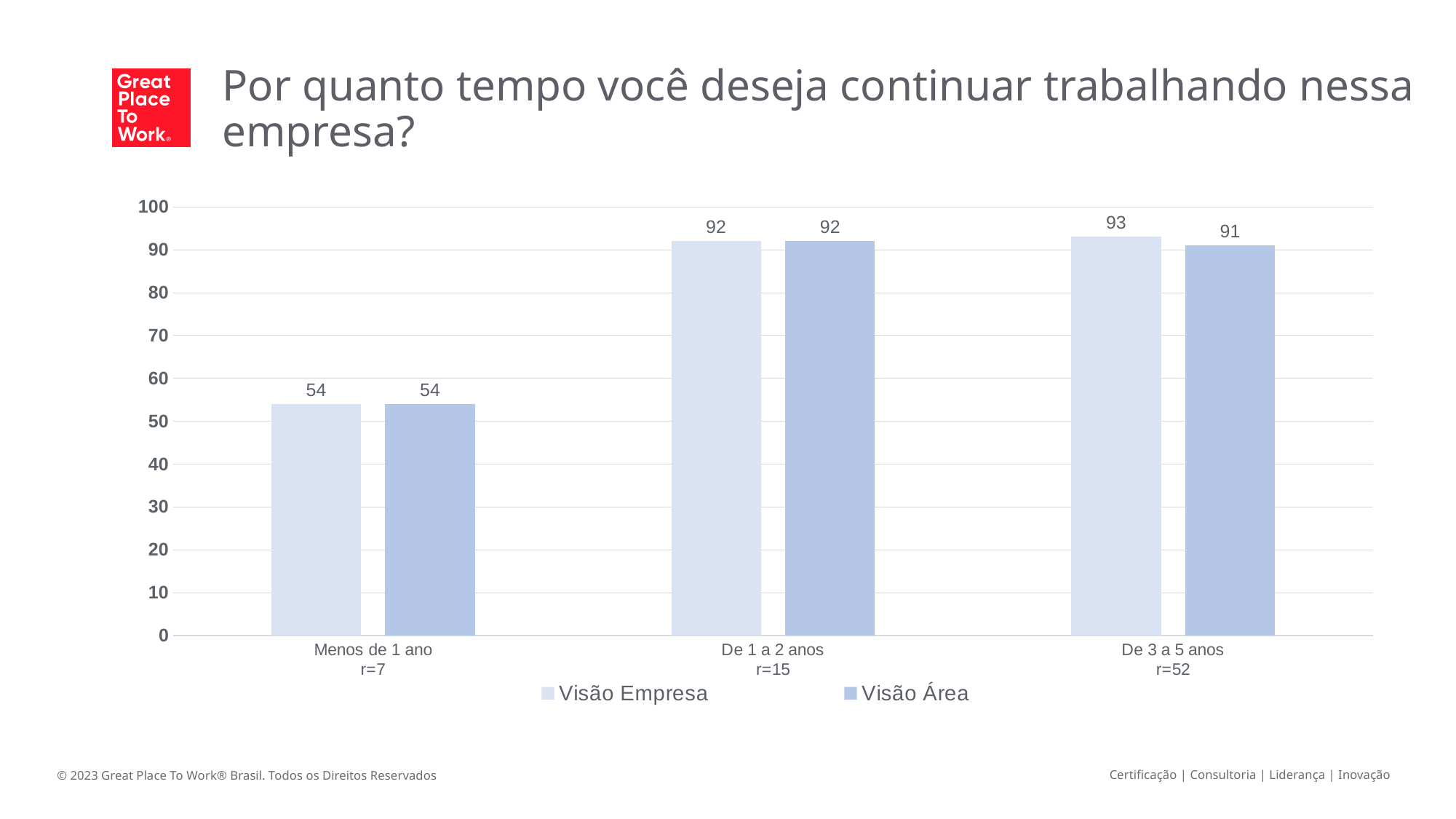
How many categories are shown on the x axis? 3 Which category has the highest Visão Empresa value? De 3 a 5 anos Do the Visão Empresa values rise or fall from 'Menos de 1 ano' to 'De 3 a 5 anos'? Rise How many series does the legend list? 2 What is the Visão Empresa value for 'Menos de 1 ano'? 54 What is the Visão Empresa value for 'De 1 a 2 anos'? 92 What is the number of respondents (r) shown for 'De 3 a 5 anos'? r=52 Which category has the lowest Visão Área value? Menos de 1 ano What is the Visão Área value for 'De 3 a 5 anos'? 91 What kind of chart is shown on the slide? Bar chart For 'De 3 a 5 anos', which series has the larger value, Visão Empresa or Visão Área? Visão Empresa What is the difference between the Visão Empresa values for 'De 3 a 5 anos' and 'Menos de 1 ano'? 39